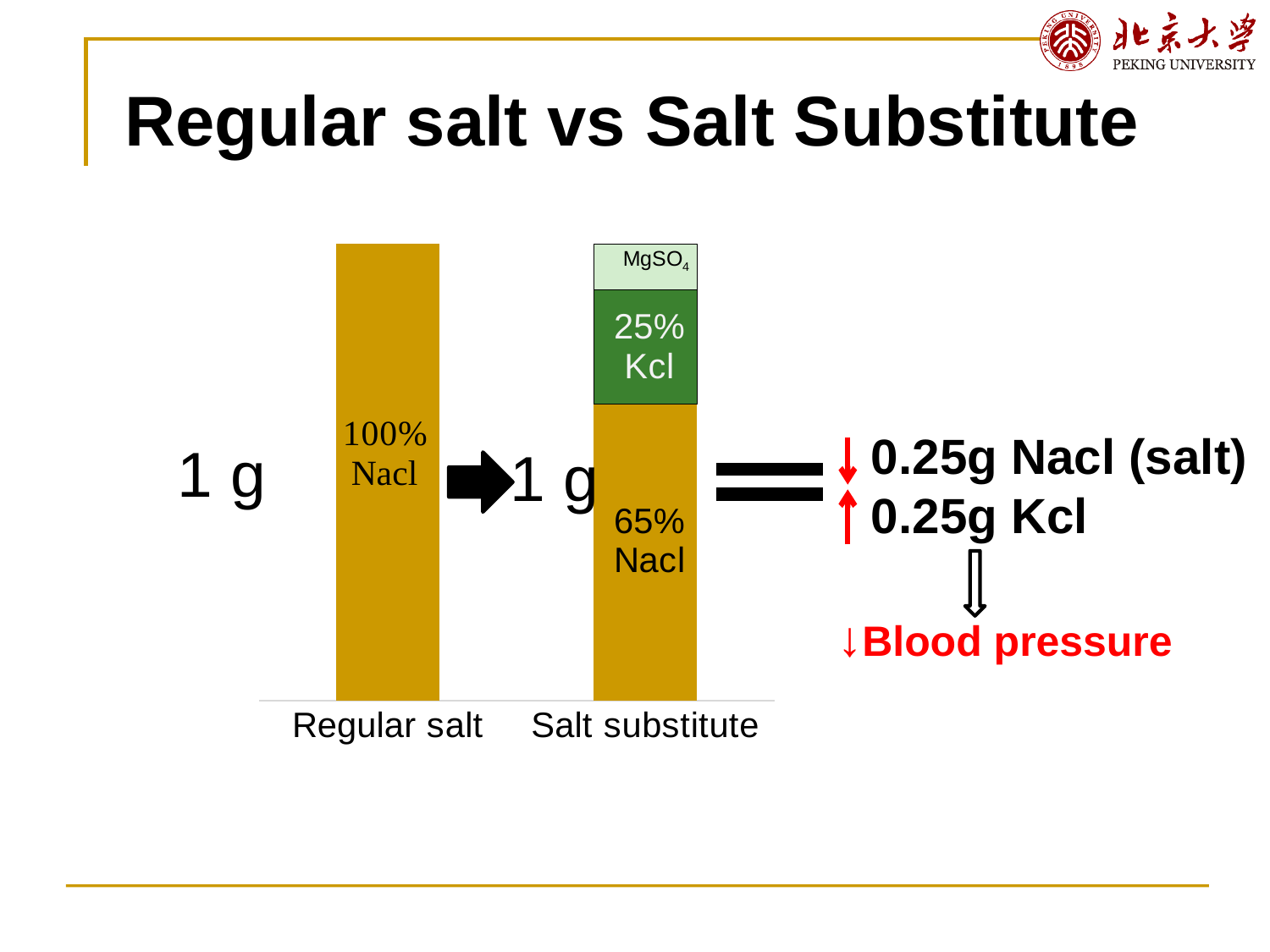
What colour is the KCl segment of the Salt substitute bar? Green What kind of chart is shown on the slide? Stacked bar chart How many categories (bars) are shown on the chart? 2 Which bar has the higher NaCl percentage, Regular salt or Salt substitute? Regular salt What is the difference in NaCl percentage between Regular salt and Salt substitute? 35% What percentage of KCl does the Salt substitute bar show? 25% Which category has the lowest NaCl percentage? Salt substitute In the Salt substitute bar, which is larger, the NaCl segment or the KCl segment? NaCl How many segments make up the Salt substitute bar? 3 What percentage of NaCl does the Regular salt bar show? 100% Which component is shown at the top of the Salt substitute bar? MgSO4 What percentage of NaCl does the Salt substitute bar show? 65%